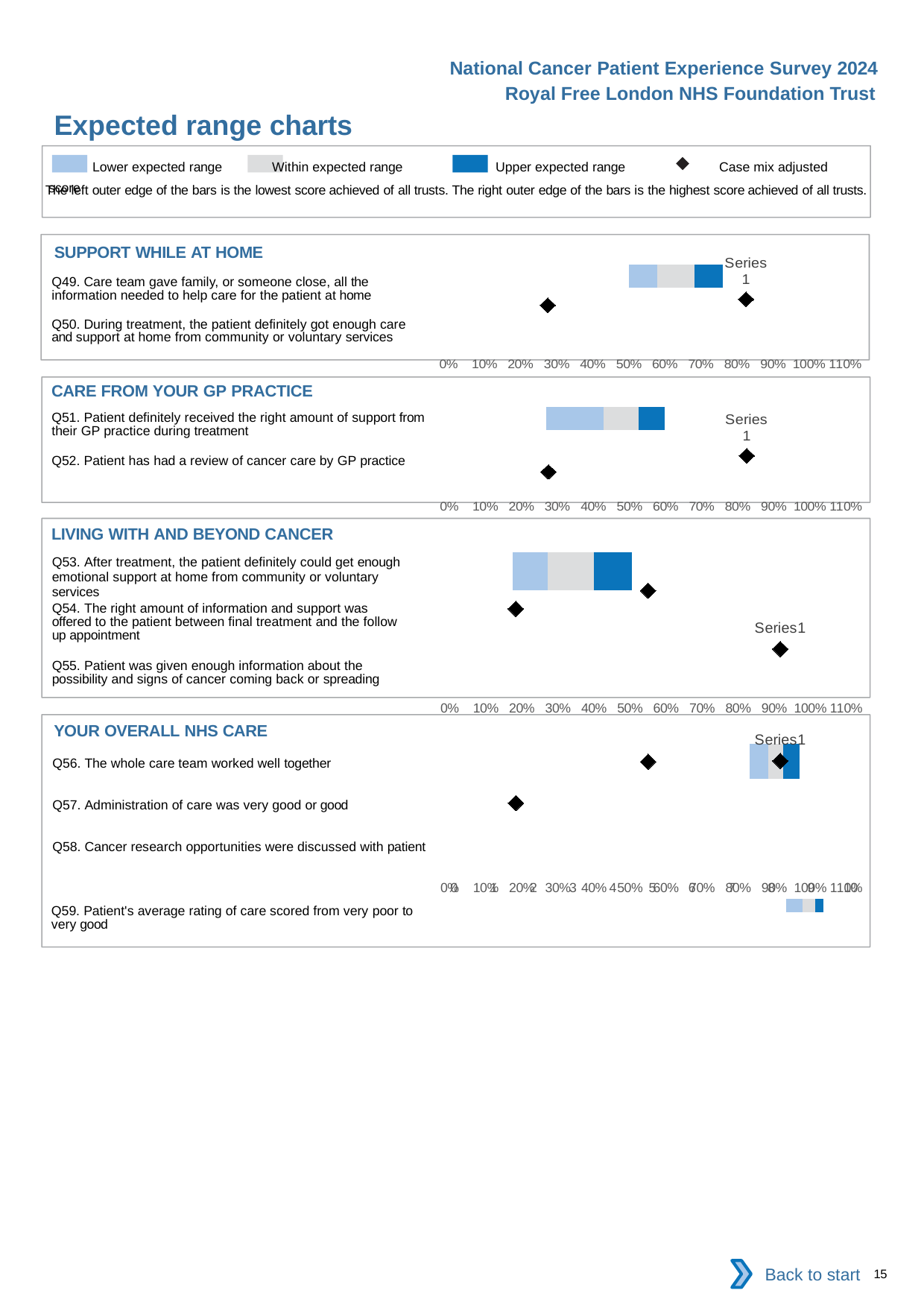
What does the diamond marker represent according to the legend? Case mix adjusted score What kind of chart is used in the SUPPORT WHILE AT HOME section? bar chart In the LIVING WITH AND BEYOND CANCER chart, is the case mix adjusted score for Q54 greater or less than 30%? less What is the highest value shown on the x axis of the CARE FROM YOUR GP PRACTICE chart? 110% How many questions are listed in the LIVING WITH AND BEYOND CANCER chart? 3 How many questions are listed in the YOUR OVERALL NHS CARE chart? 4 In the LIVING WITH AND BEYOND CANCER chart, is the case mix adjusted score for Q53 greater or less than 40%? greater